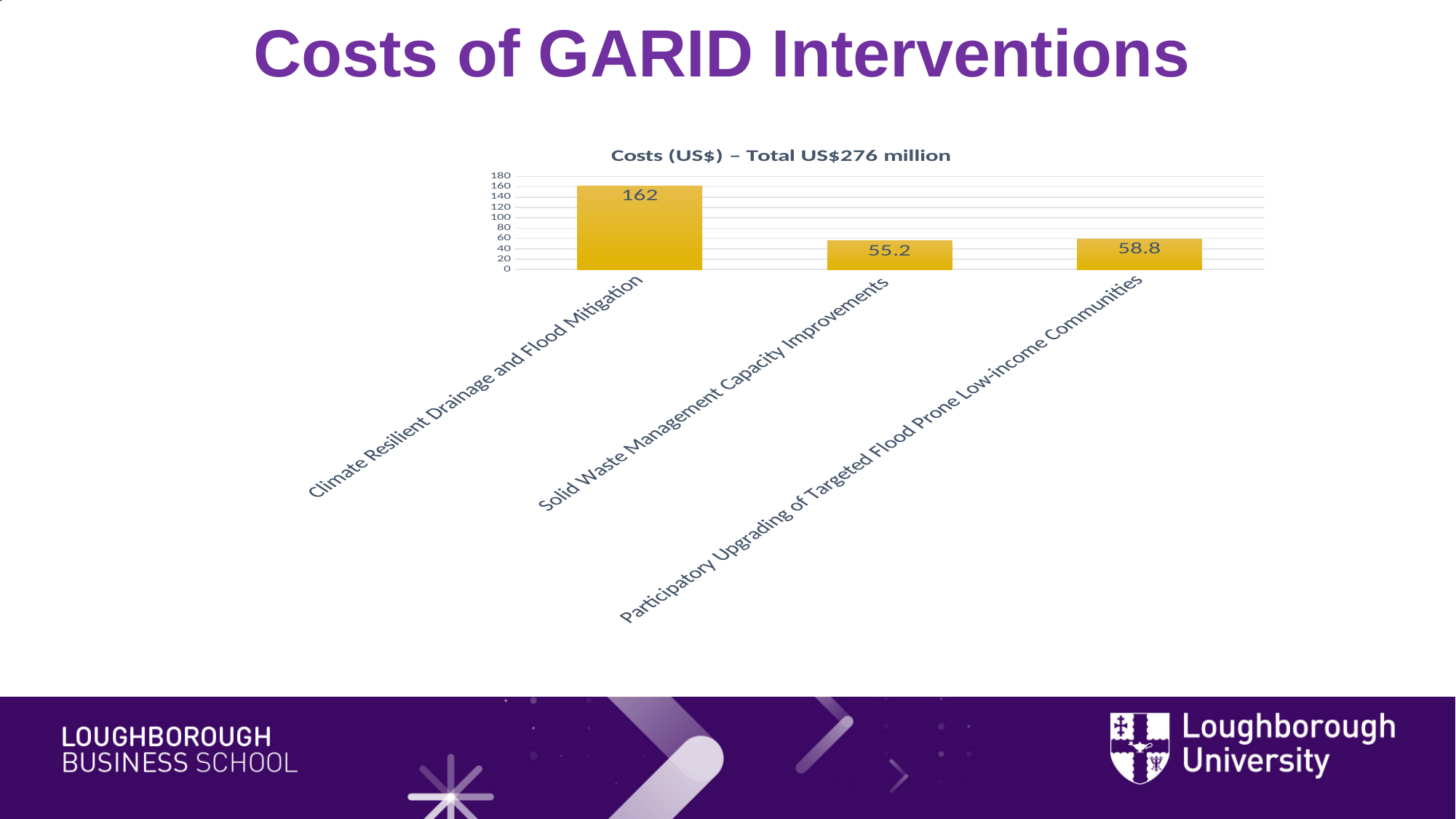
What is the value for Participatory Upgrading of Targeted Flood Prone Low-income Communities? 58.8 Which category has the lowest cost? Solid Waste Management Capacity Improvements What kind of chart is shown on the slide? bar chart What is the value for Climate Resilient Drainage and Flood Mitigation? 162 How many categories are shown in the chart? 3 Is the value for Solid Waste Management Capacity Improvements greater or less than 100? less What is the difference between the values for Participatory Upgrading of Targeted Flood Prone Low-income Communities and Solid Waste Management Capacity Improvements? 3.6 Which is larger: the value for Climate Resilient Drainage and Flood Mitigation or the value for Participatory Upgrading of Targeted Flood Prone Low-income Communities? Climate Resilient Drainage and Flood Mitigation Which category has the highest cost? Climate Resilient Drainage and Flood Mitigation What is the difference between the values for Climate Resilient Drainage and Flood Mitigation and Solid Waste Management Capacity Improvements? 106.8 What is the value for Solid Waste Management Capacity Improvements? 55.2 What is the title of the chart? Costs (US$) – Total US$276 million